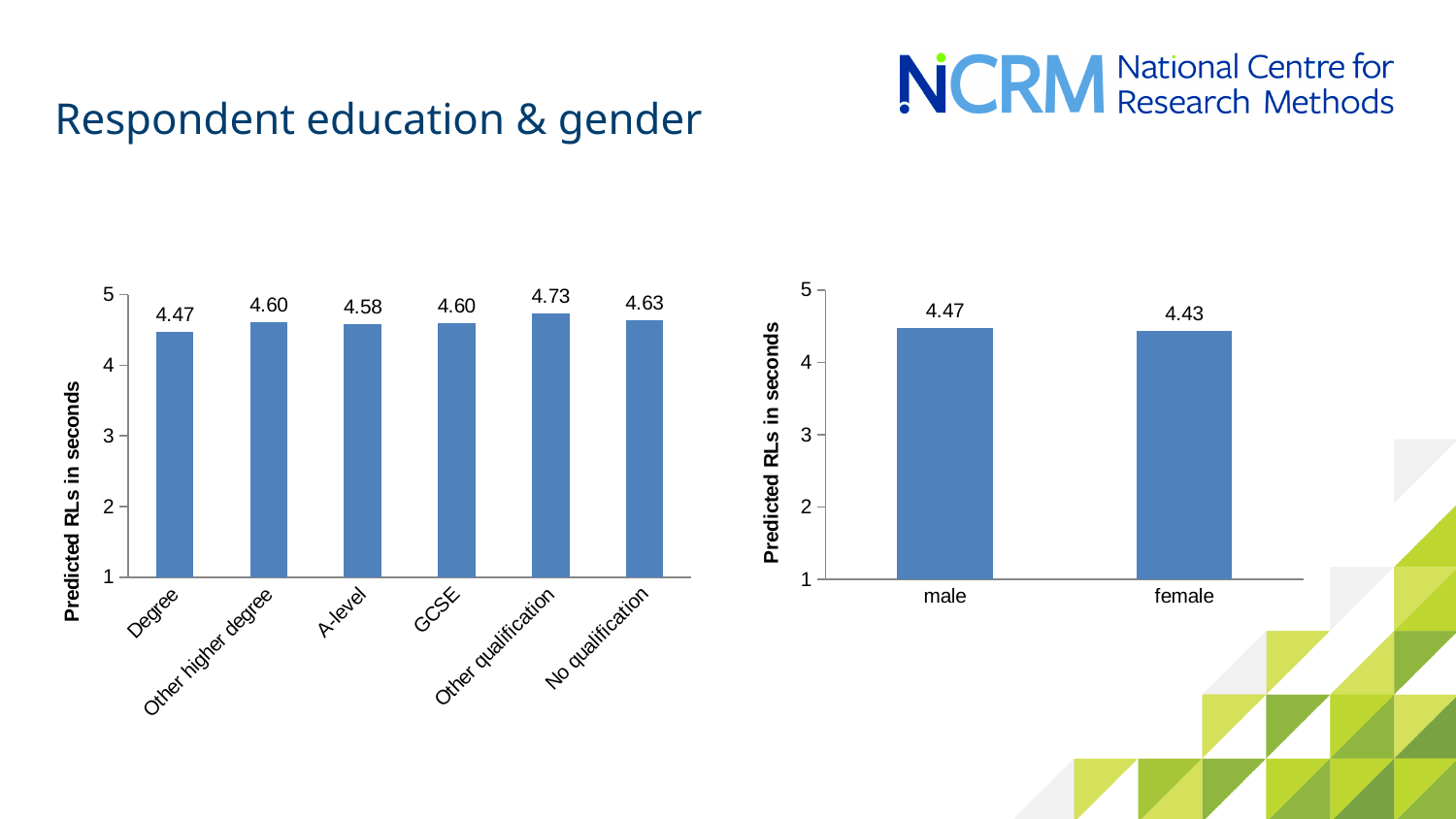
In the left chart (education), what is the predicted RLs in seconds for Degree? 4.47 In the right chart (gender), which is larger, the value for male or for female? male What kind of chart is the right chart (gender)? bar chart In the left chart (education), is the value for No qualification greater or less than 4? greater In the left chart (education), what is the predicted RLs in seconds for Other qualification? 4.73 In the left chart (education), which education category has the lowest predicted RLs? Degree What is the y-axis label of the left chart (education)? Predicted RLs in seconds In the left chart (education), which education category has the highest predicted RLs? Other qualification In the left chart (education), how many education categories are shown? 6 In the right chart (gender), what is the predicted RLs in seconds for female? 4.43 In the left chart (education), what is the difference between the values for Other qualification and Degree? 0.26 In the right chart (gender), what is the difference between the values for male and female? 0.04